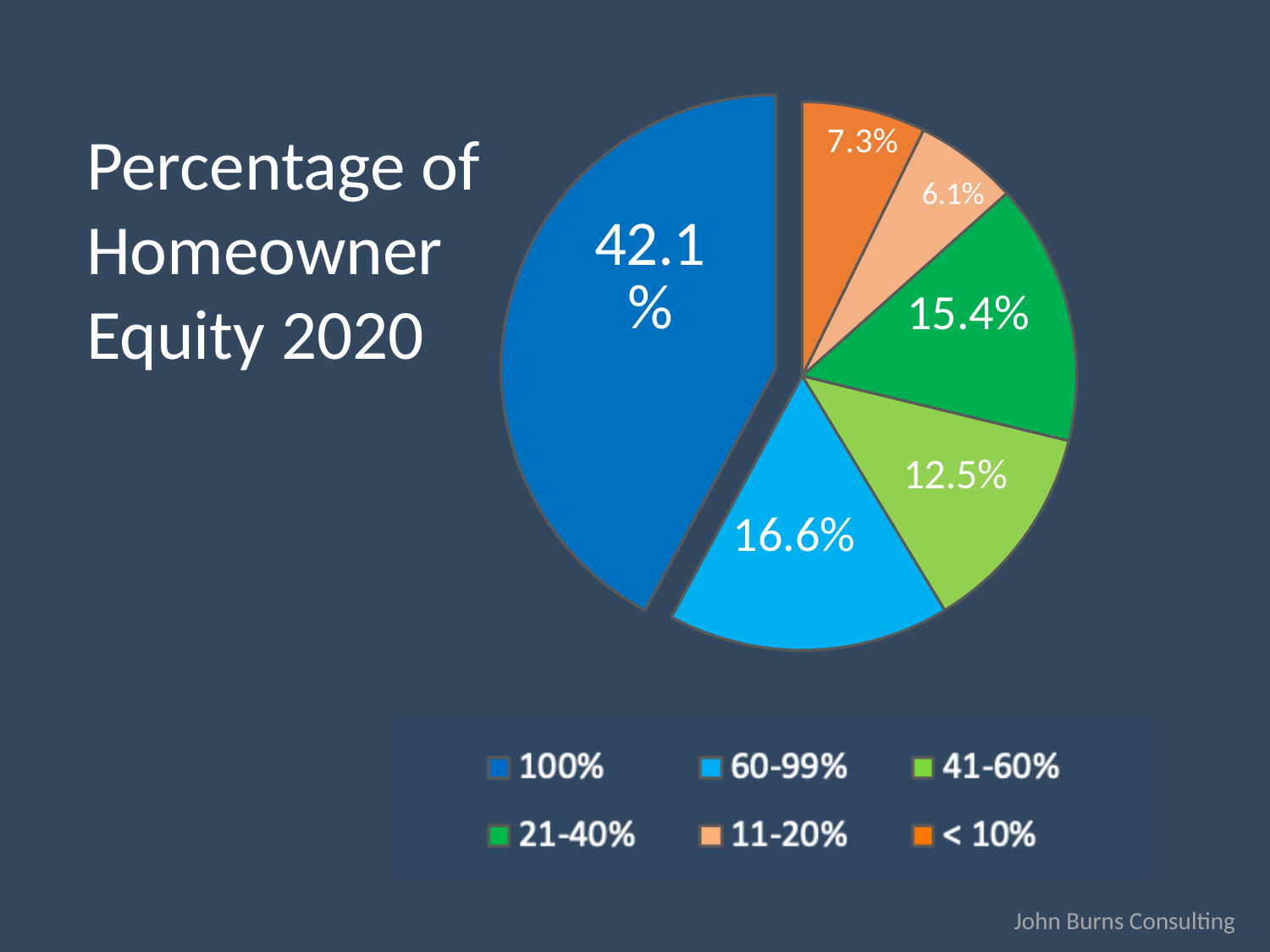
Which is larger, the 21-40% equity share or the 41-60% equity share? 21-40% What kind of chart is shown on the slide? pie chart How many categories does the legend list? 6 Which equity category has the largest slice of the pie? 100% What share of homeowners have 11-20% equity? 6.1% What share of homeowners have 41-60% equity? 12.5% What share of homeowners have 100% equity? 42.1% Which equity category has the smallest slice of the pie? 11-20% What share of homeowners have 21-40% equity? 15.4% What share of homeowners have 60-99% equity? 16.6% What share of homeowners have less than 10% equity? 7.3% What is the difference between the 100% equity share and the 60-99% equity share? 25.5%